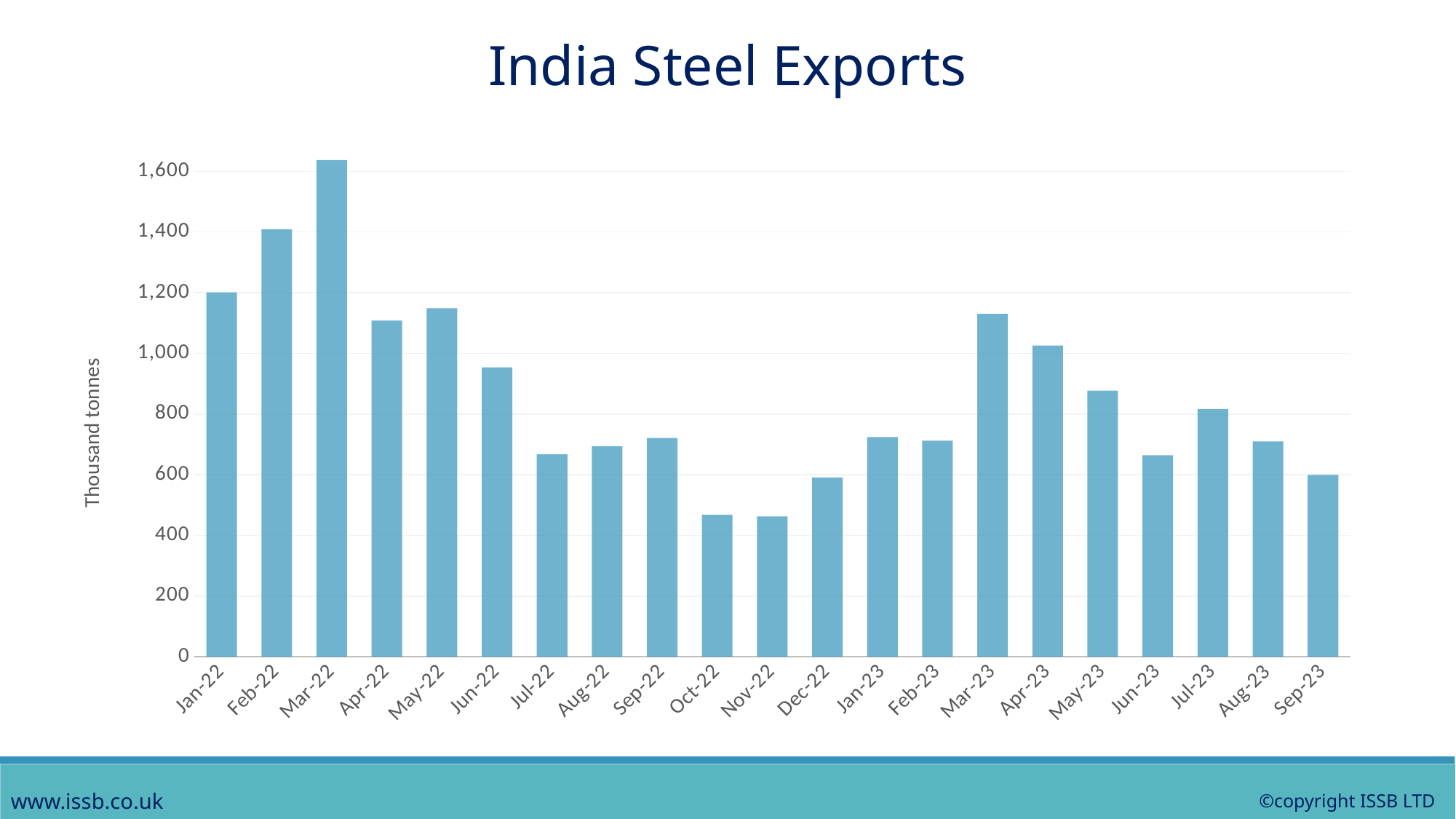
Is the value for Mar-23 greater or less than 1,000? greater Is the value for Oct-22 greater or less than 600? less What is the label on the vertical axis of the chart? Thousand tonnes What kind of chart is shown on the slide? bar chart What is the title of the chart? India Steel Exports Is the value for Mar-22 greater or less than 1,600? greater Do the values rise or fall from Mar-22 to Jul-22? fall How many months (bars) are plotted on the chart? 21 Which is larger, the value for Mar-23 or the value for Apr-23? Mar-23 Which month has the highest steel exports? Mar-22